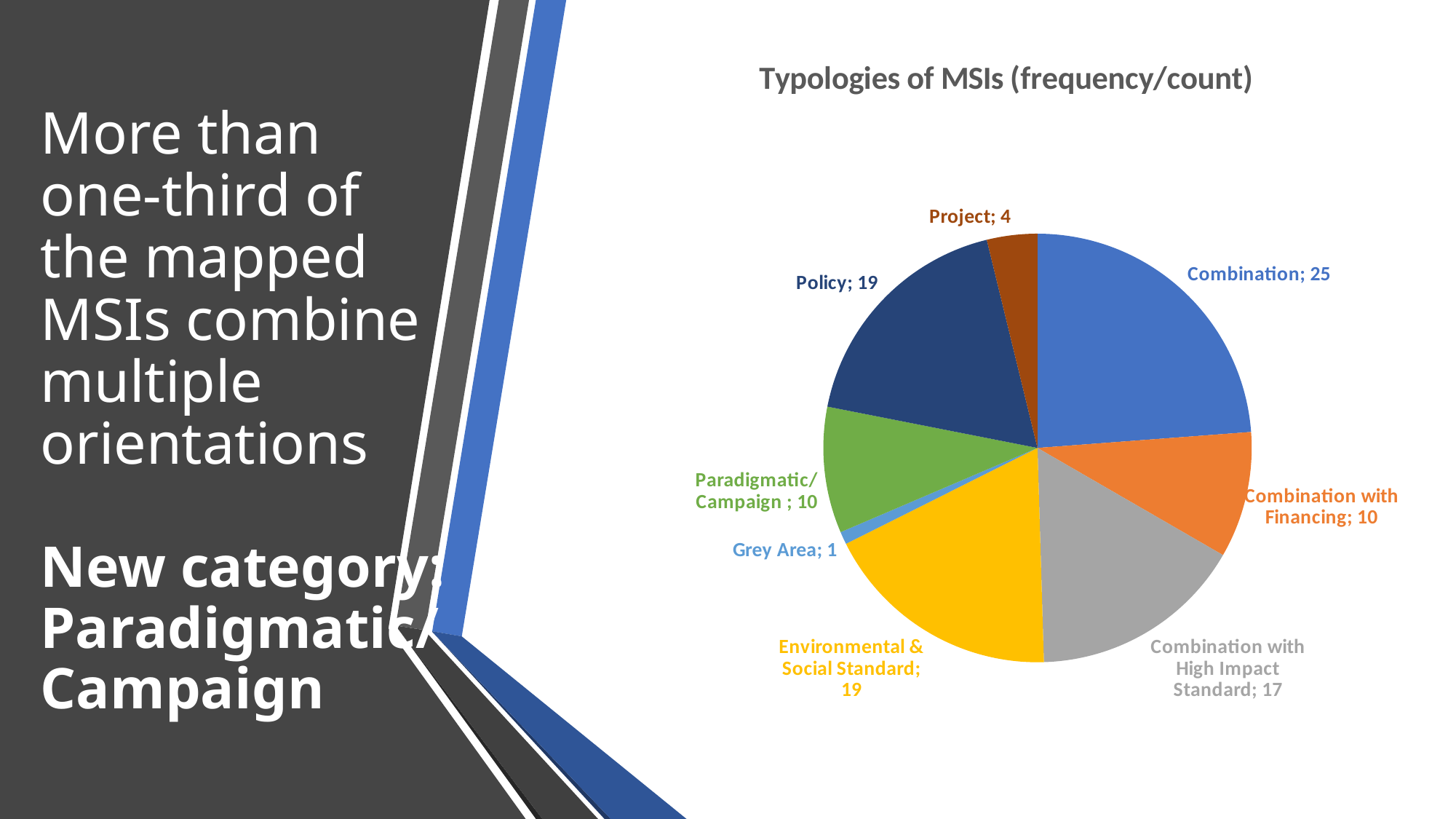
What is the difference between the counts for Combination and Policy? 6 What is the count for Project? 4 What is the count for Combination? 25 Which is larger, the count for Combination with High Impact Standard or the count for Combination with Financing? Combination with High Impact Standard What is the title of the chart? Typologies of MSIs (frequency/count) What is the count for Combination with High Impact Standard? 17 Which category has the lowest count? Grey Area What is the count for Paradigmatic/Campaign? 10 How many categories (slices) does the pie chart show? 8 What type of chart is shown on the slide? Pie chart What is the difference between the counts for Environmental & Social Standard and Project? 15 Which category has the highest count? Combination